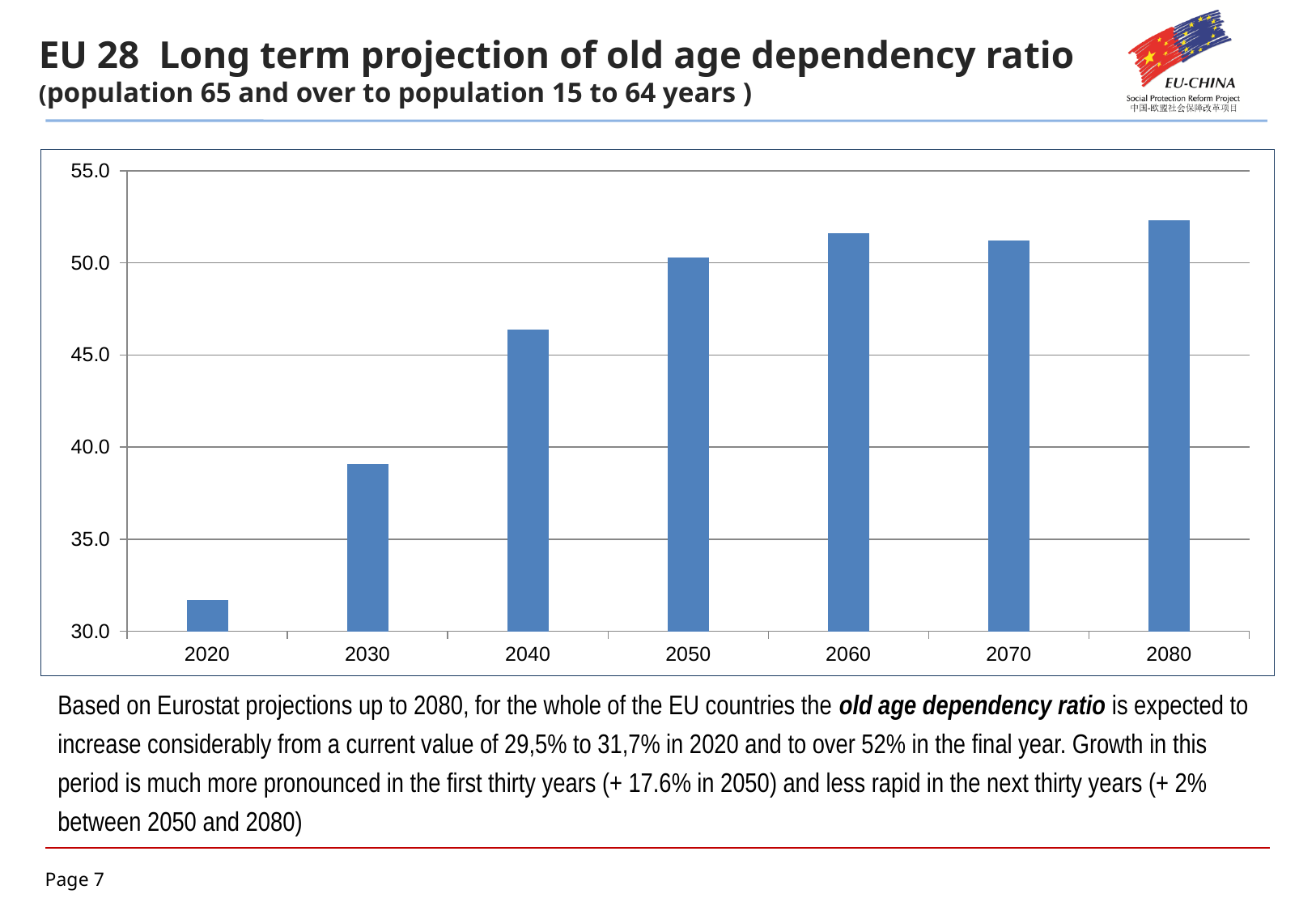
Do the values generally rise or fall from 2020 to 2080? rise What kind of chart is shown on the slide? bar chart How many years (bars) are plotted on the chart? 7 Which year has the lowest old age dependency ratio on the chart? 2020 Is the value for 2050 greater or less than 50.0? greater Is the value for 2030 greater or less than 40.0? less Is the value for 2020 greater or less than 35.0? less What is the first year shown on the x axis of the chart? 2020 Which is larger, the value for 2030 or the value for 2040? 2040 Which is larger, the value for 2040 or the value for 2050? 2050